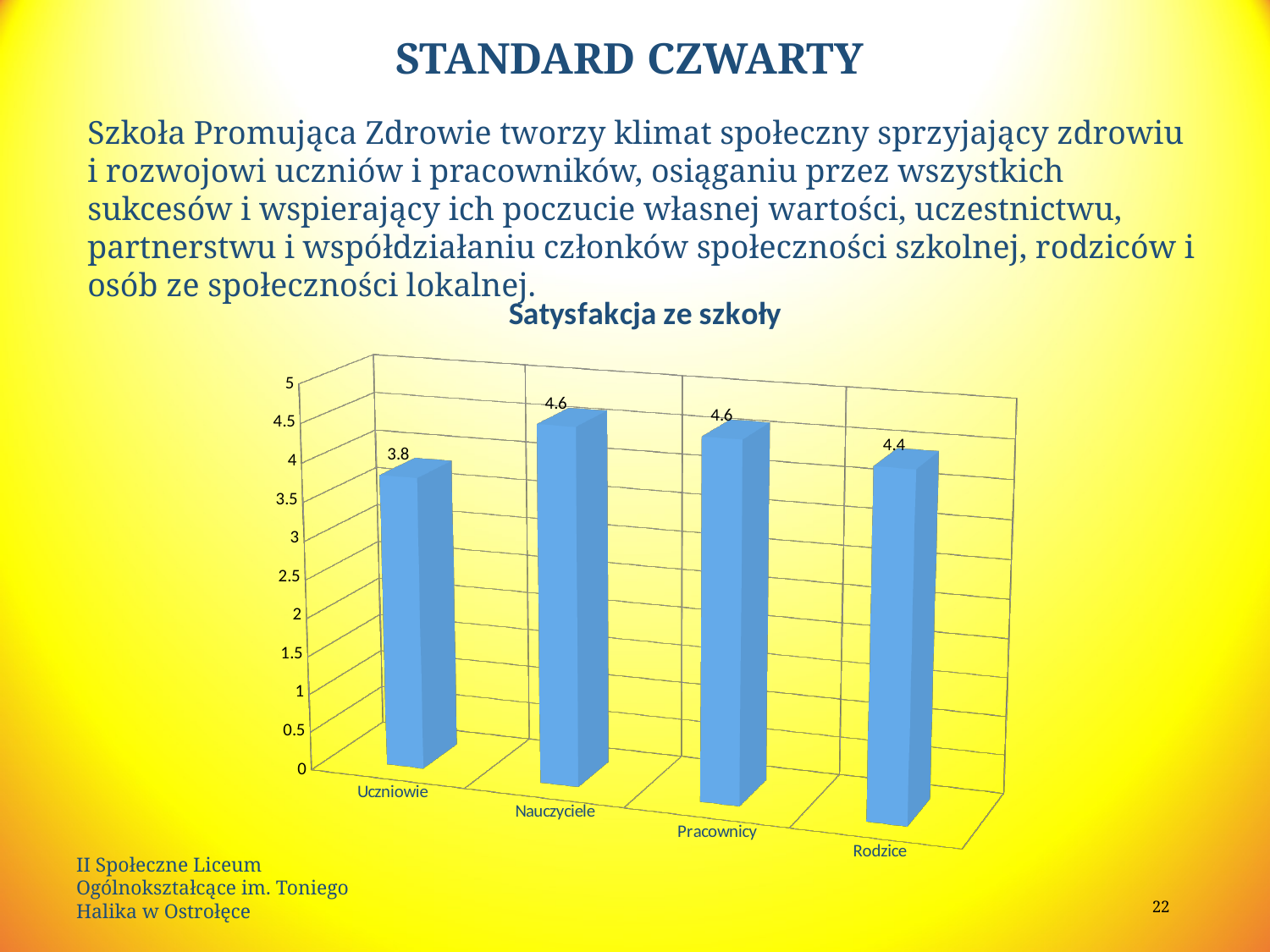
How many categories are shown on the chart? 4 What is the value for Uczniowie? 3.8 Which category has the lowest value? Uczniowie What is the difference between the values for Pracownicy and Rodzice? 0.2 What kind of chart is shown on the slide? bar chart What is the difference between the values for Nauczyciele and Uczniowie? 0.8 Which is larger, the value for Rodzice or the value for Uczniowie? Rodzice What is the value for Nauczyciele? 4.6 What is the value for Rodzice? 4.4 What is the value for Pracownicy? 4.6 Is the value for Uczniowie greater or less than 4? less What is the title of the chart? Satysfakcja ze szkoły